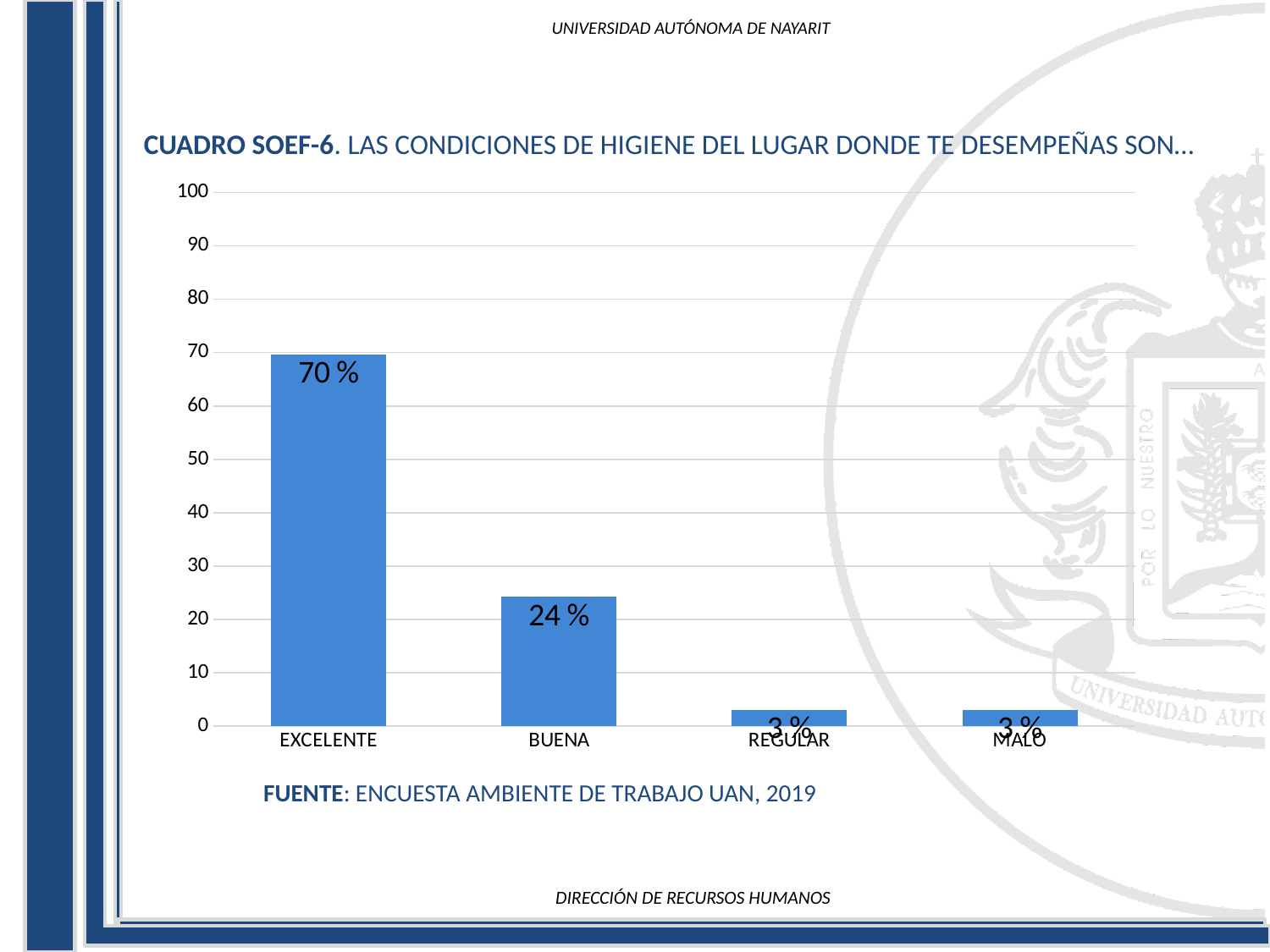
What value is shown for MALO? 3 % What kind of chart is shown on the slide? bar chart How many categories are shown on the x axis? 4 Which is larger, the value for BUENA or the value for REGULAR? BUENA What source is cited below the chart? ENCUESTA AMBIENTE DE TRABAJO UAN, 2019 What value is shown for REGULAR? 3 % What value is shown for EXCELENTE? 70 % Which category has the highest value? EXCELENTE What value is shown for BUENA? 24 % Is the value for EXCELENTE greater or less than 60? greater Is the value for BUENA greater or less than 30? less What is the difference between the values for EXCELENTE and BUENA? 46 %